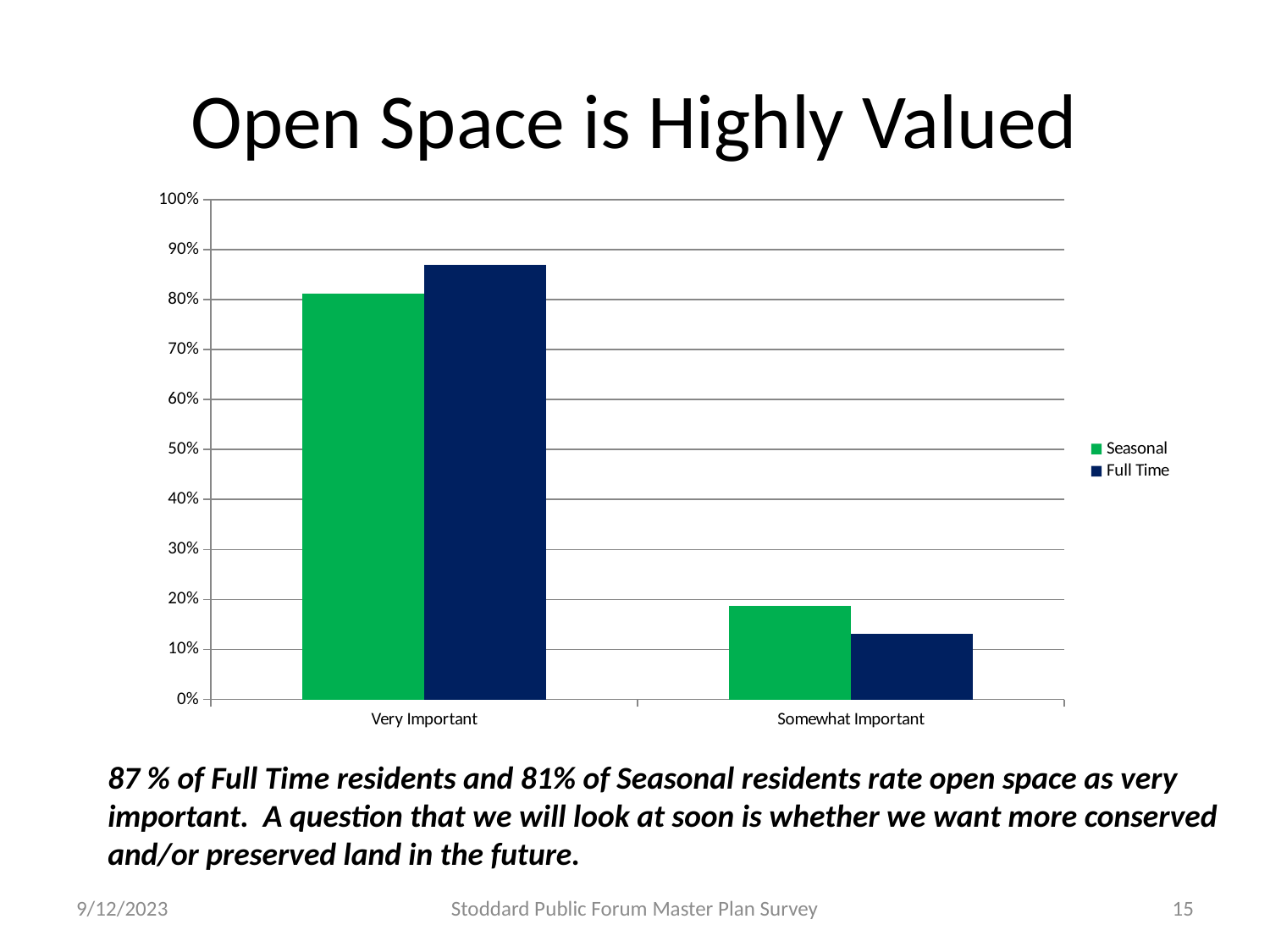
Is the Full Time value for Somewhat Important greater or less than 20%? less How many categories are shown on the x axis? 2 What is the title of the chart slide? Open Space is Highly Valued What are the two series named in the legend? Seasonal and Full Time For Very Important, which series has the larger value, Seasonal or Full Time? Full Time What kind of chart is shown on the slide? Bar chart What percentage of Seasonal residents rate open space as Very Important? 81% What is the difference between the Full Time and Seasonal values for Very Important? 6 percentage points Is the Seasonal value for Somewhat Important greater or less than 10%? greater For Somewhat Important, which series has the larger value, Seasonal or Full Time? Seasonal What percentage of Full Time residents rate open space as Very Important? 87% How many series does the legend list? 2